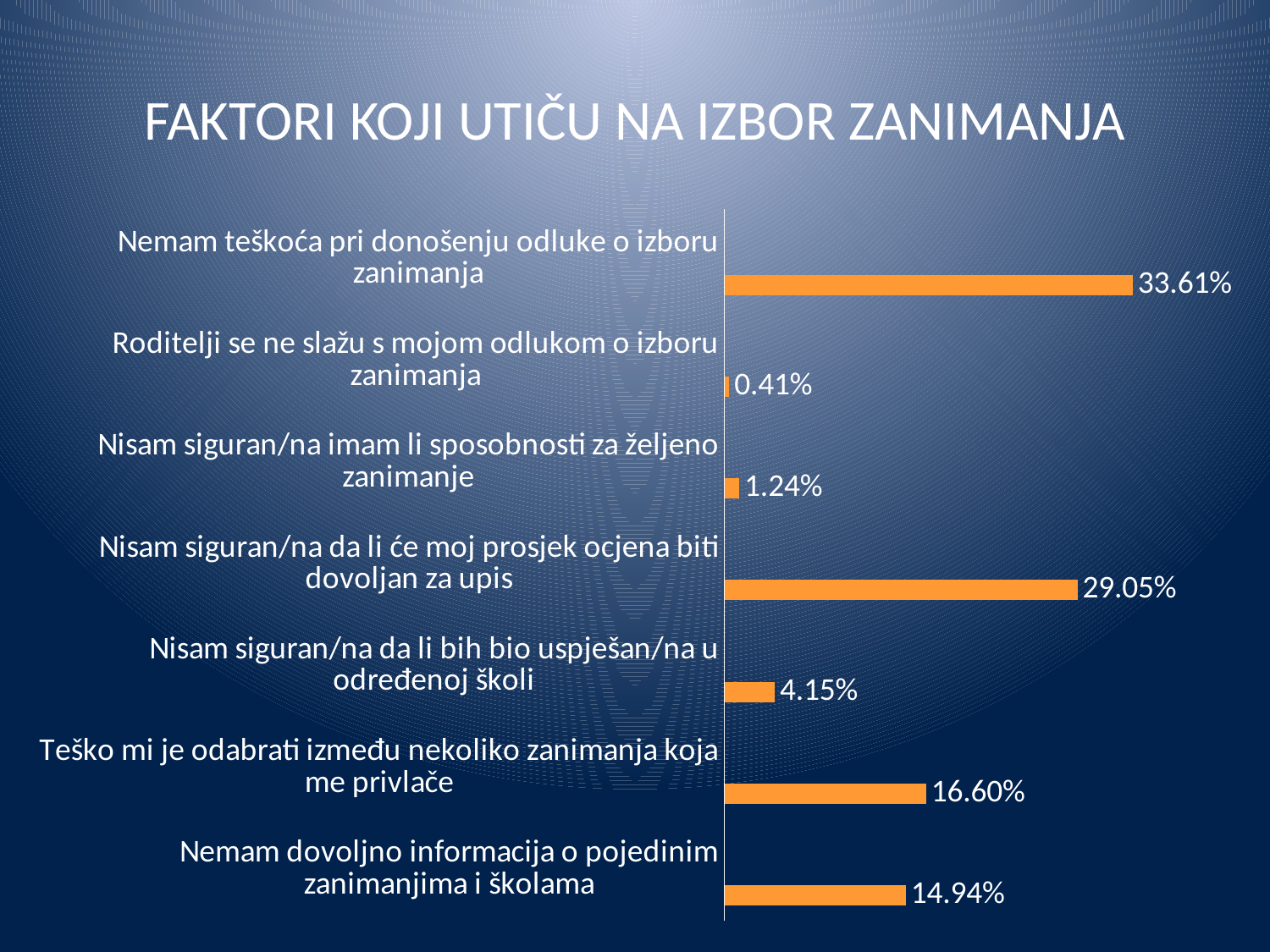
Which category has the highest value? Nemam teškoća pri donošenju odluke o izboru zanimanja What kind of chart is shown on the slide? Bar chart What colour are the bars in the chart? Orange Which category has the lowest value? Roditelji se ne slažu s mojom odlukom o izboru zanimanja Which is larger: the value for "Nisam siguran/na da li bih bio uspješan/na u određenoj školi" or the value for "Nisam siguran/na imam li sposobnosti za željeno zanimanje"? Nisam siguran/na da li bih bio uspješan/na u određenoj školi What is the value for "Nemam dovoljno informacija o pojedinim zanimanjima i školama"? 14.94% How many categories does the chart show? 7 What is the difference between the values for "Nemam teškoća pri donošenju odluke o izboru zanimanja" and "Nisam siguran/na da li će moj prosjek ocjena biti dovoljan za upis"? 4.56% What is the value for "Roditelji se ne slažu s mojom odlukom o izboru zanimanja"? 0.41% What is the value for "Teško mi je odabrati između nekoliko zanimanja koja me privlače"? 16.60% What is the title of the chart on the slide? FAKTORI KOJI UTIČU NA IZBOR ZANIMANJA What is the value for "Nemam teškoća pri donošenju odluke o izboru zanimanja"? 33.61%